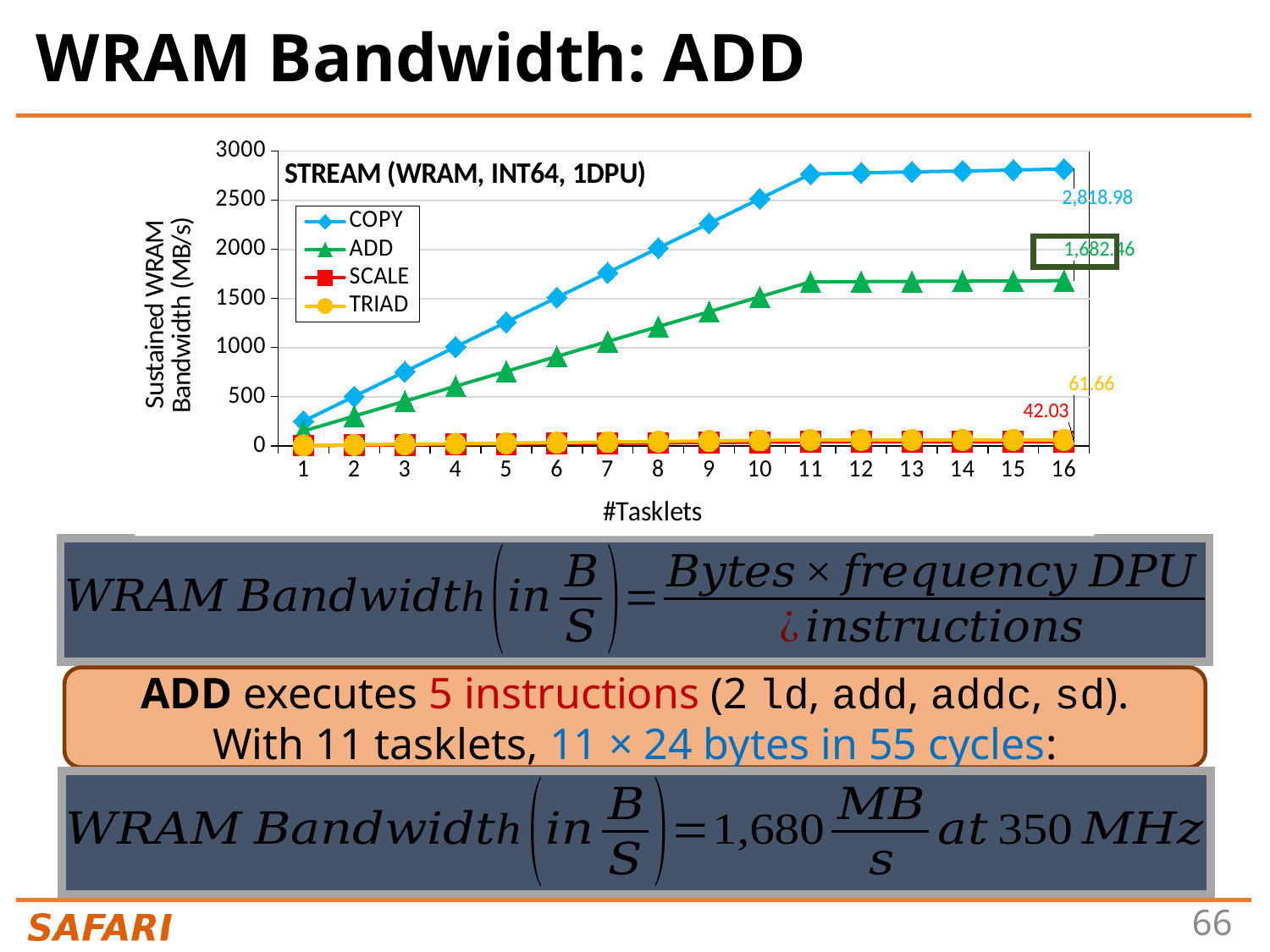
What is the title shown inside the chart? STREAM (WRAM, INT64, 1DPU) How many tasklet values are plotted along the x axis? 16 Which series has the highest bandwidth at 16 tasklets? COPY What is the label of the x axis? #Tasklets What is the COPY bandwidth at 16 tasklets? 2,818.98 Which series has the lowest bandwidth at 16 tasklets? SCALE Does the COPY bandwidth rise or fall as the number of tasklets increases from 1 to 11? rise What is the TRIAD bandwidth at 16 tasklets? 61.66 How many series does the chart legend list? 4 Is the ADD bandwidth at 11 tasklets greater or less than 1500? greater What type of chart is shown on the slide? line chart What is the SCALE bandwidth at 16 tasklets? 42.03